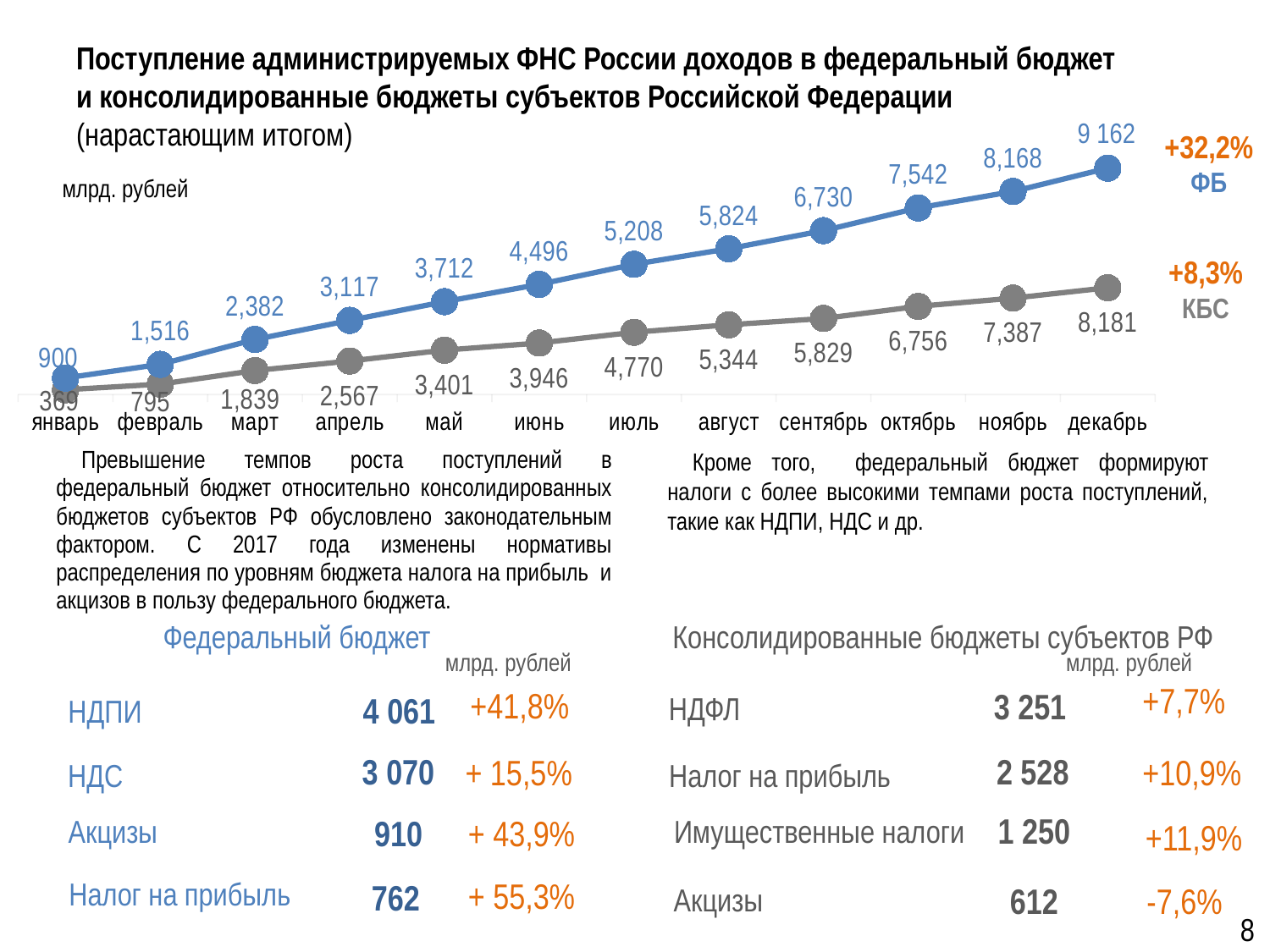
How many months are plotted along the x axis? 12 What is the value of the КБС (grey) line for сентябрь? 5,829 What is the value of the ФБ line for декабрь? 9 162 What is the value of the КБС line for январь? 369 In which month is the КБС line at its lowest value? январь In which month does the ФБ line reach its highest value? декабрь Do the values of the ФБ line rise or fall from январь to декабрь? rise Which line has the higher value in август, ФБ or КБС? ФБ What type of chart is shown on the slide? line chart What is the difference between the ФБ and КБС values in декабрь? 981 How many lines (series) are plotted on the chart? 2 What is the value of the ФБ (blue) line for май? 3,712